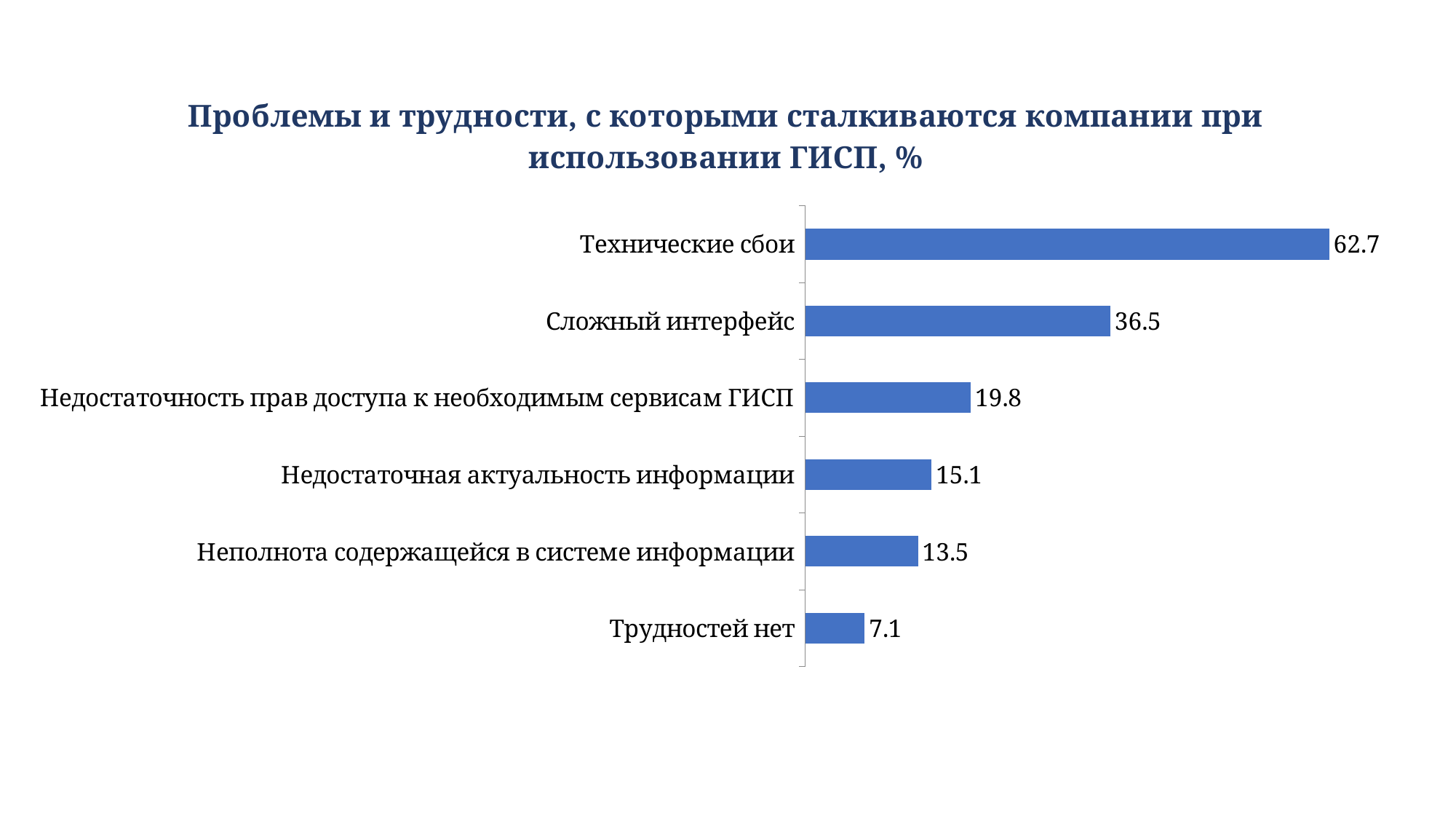
What is the value for Технические сбои? 62.7 What is the value for Трудностей нет? 7.1 What is the value for Сложный интерфейс? 36.5 What kind of chart is shown on the slide? Bar chart What is the difference between the values for Недостаточная актуальность информации and Неполнота содержащейся в системе информации? 1.6 Which category has the lowest value? Трудностей нет Which is larger: the value for Недостаточность прав доступа к необходимым сервисам ГИСП or the value for Недостаточная актуальность информации? Недостаточность прав доступа к необходимым сервисам ГИСП What is the title of the chart? Проблемы и трудности, с которыми сталкиваются компании при использовании ГИСП, % Which category has the highest value? Технические сбои What is the difference between the values for Технические сбои and Сложный интерфейс? 26.2 How many categories are shown in the chart? 6 What is the value for Недостаточность прав доступа к необходимым сервисам ГИСП? 19.8